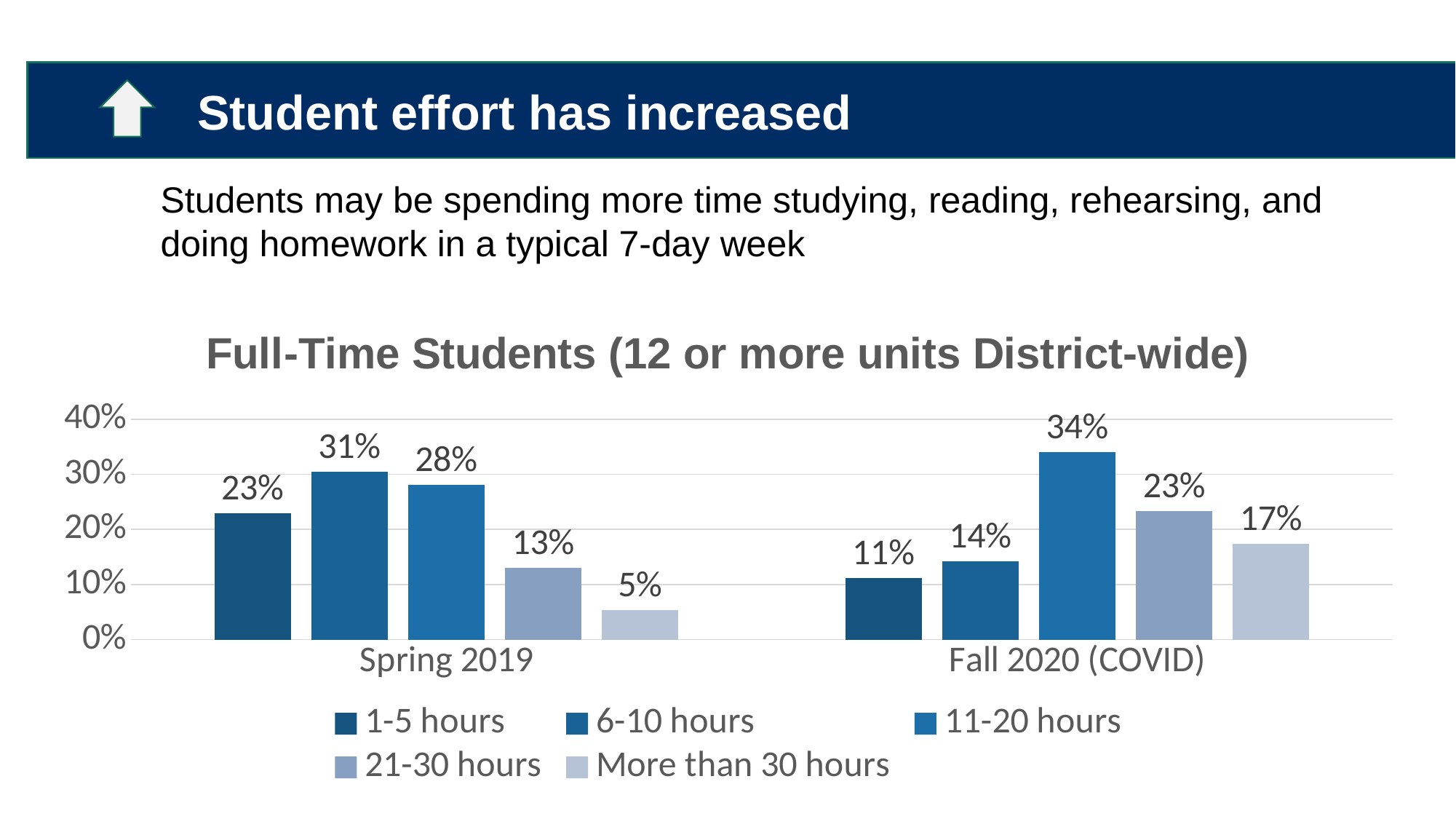
What is the value for More than 30 hours in Spring 2019? 5% What is the difference between the 1-5 hours values for Spring 2019 and Fall 2020 (COVID)? 12% What is the title of the chart? Full-Time Students (12 or more units District-wide) What percentage of full-time students reported 11-20 hours in Fall 2020 (COVID)? 34% Is the value for 11-20 hours in Fall 2020 (COVID) greater or less than 30%? greater Which hours category has the lowest value in Spring 2019? More than 30 hours What percentage of full-time students reported 6-10 hours in Spring 2019? 31% How many series does the legend list? 5 Which hours category has the highest value in Fall 2020 (COVID)? 11-20 hours What kind of chart is shown on the slide? Bar chart What is the value for 21-30 hours in Fall 2020 (COVID)? 23% Which is larger: the More than 30 hours value in Spring 2019 or in Fall 2020 (COVID)? Fall 2020 (COVID)